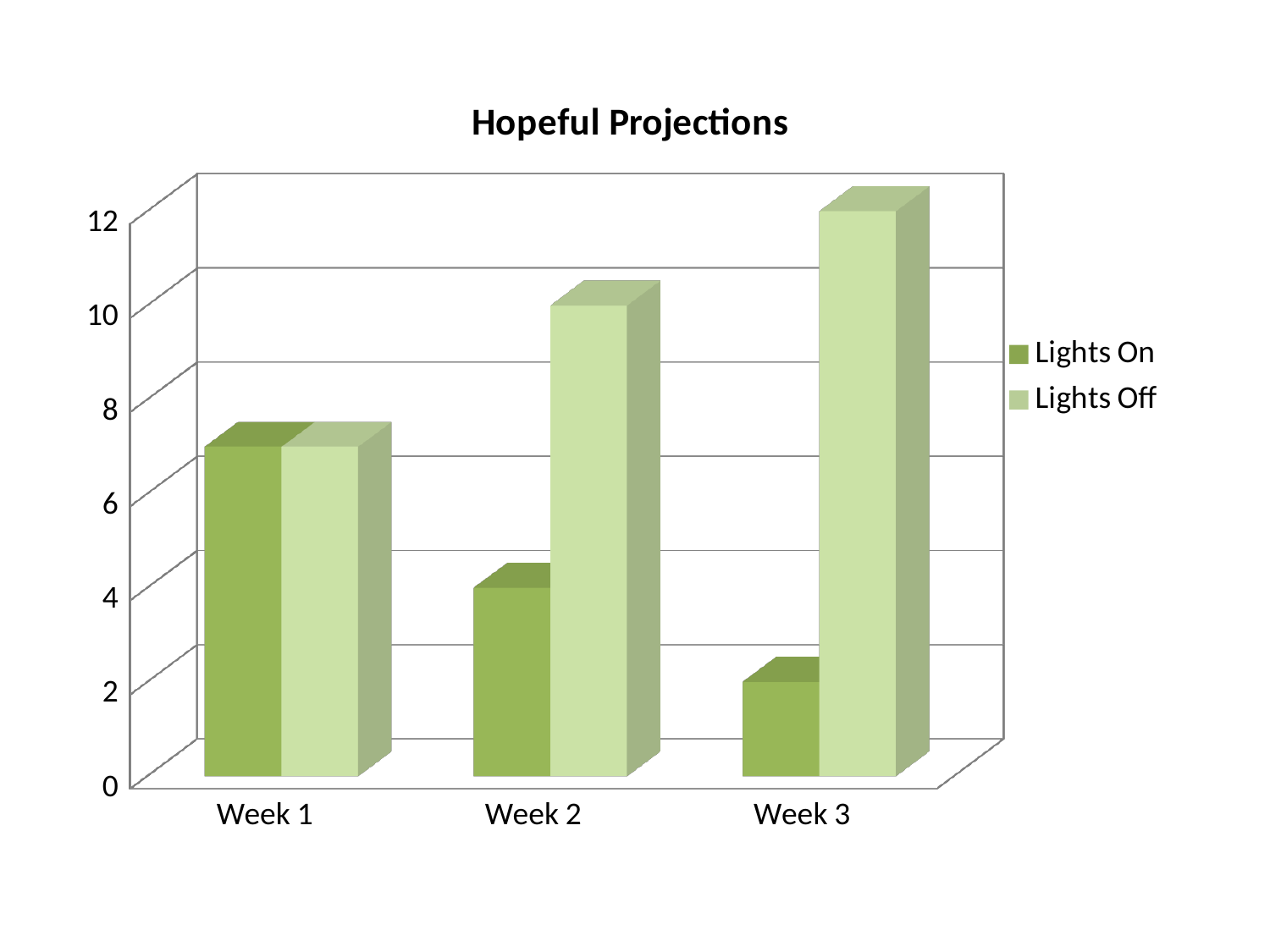
How many categories are shown on the x axis? 3 Is the Lights On value for Week 3 greater or less than 4? less Do the Lights On values rise or fall from Week 1 to Week 3? fall How many series does the legend list? 2 What is the title of the chart? Hopeful Projections Is the Lights On value for Week 1 greater or less than 6? greater What kind of chart is shown on the slide? Bar chart Which week has the lowest Lights On value? Week 3 Do the Lights Off values rise or fall from Week 1 to Week 3? rise Which week has the highest Lights Off value? Week 3 In Week 2, which is larger, Lights On or Lights Off? Lights Off Is the Lights Off value for Week 3 greater or less than 10? greater